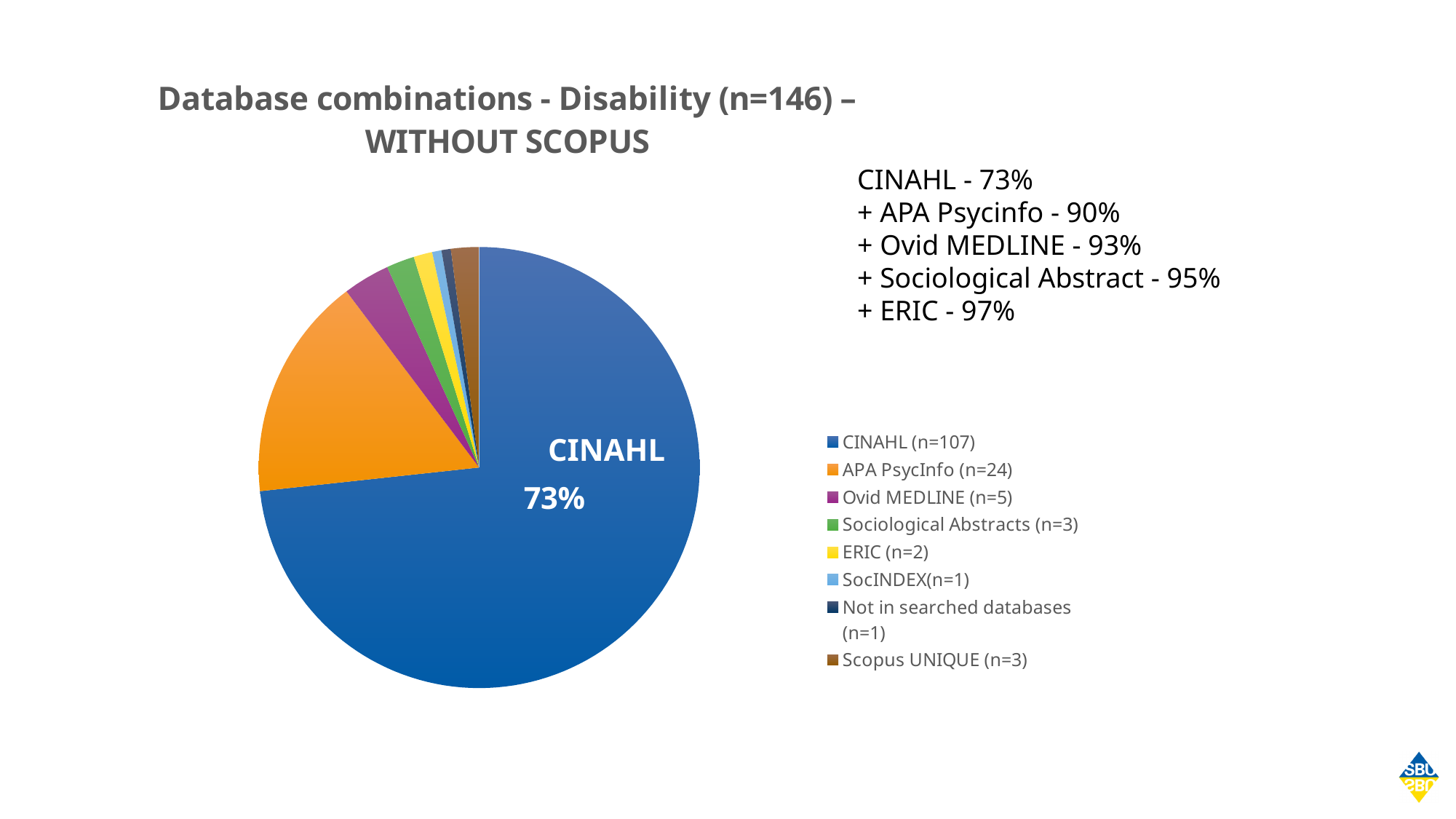
Which has a larger n value, Ovid MEDLINE or ERIC? Ovid MEDLINE What is the n value for CINAHL in the legend? 107 How many slices does the pie chart have? 8 What kind of chart is shown on the slide? pie chart What colour is the APA PsycInfo slice? orange What is the difference between the n values for CINAHL and APA PsycInfo? 83 What is the n value for Scopus UNIQUE in the legend? 3 What is the n value for APA PsycInfo in the legend? 24 Which category has the largest slice in the pie chart? CINAHL What share of the pie does the CINAHL slice represent? 73% What is the n value for Ovid MEDLINE in the legend? 5 What is the title of the chart? Database combinations - Disability (n=146) – WITHOUT SCOPUS